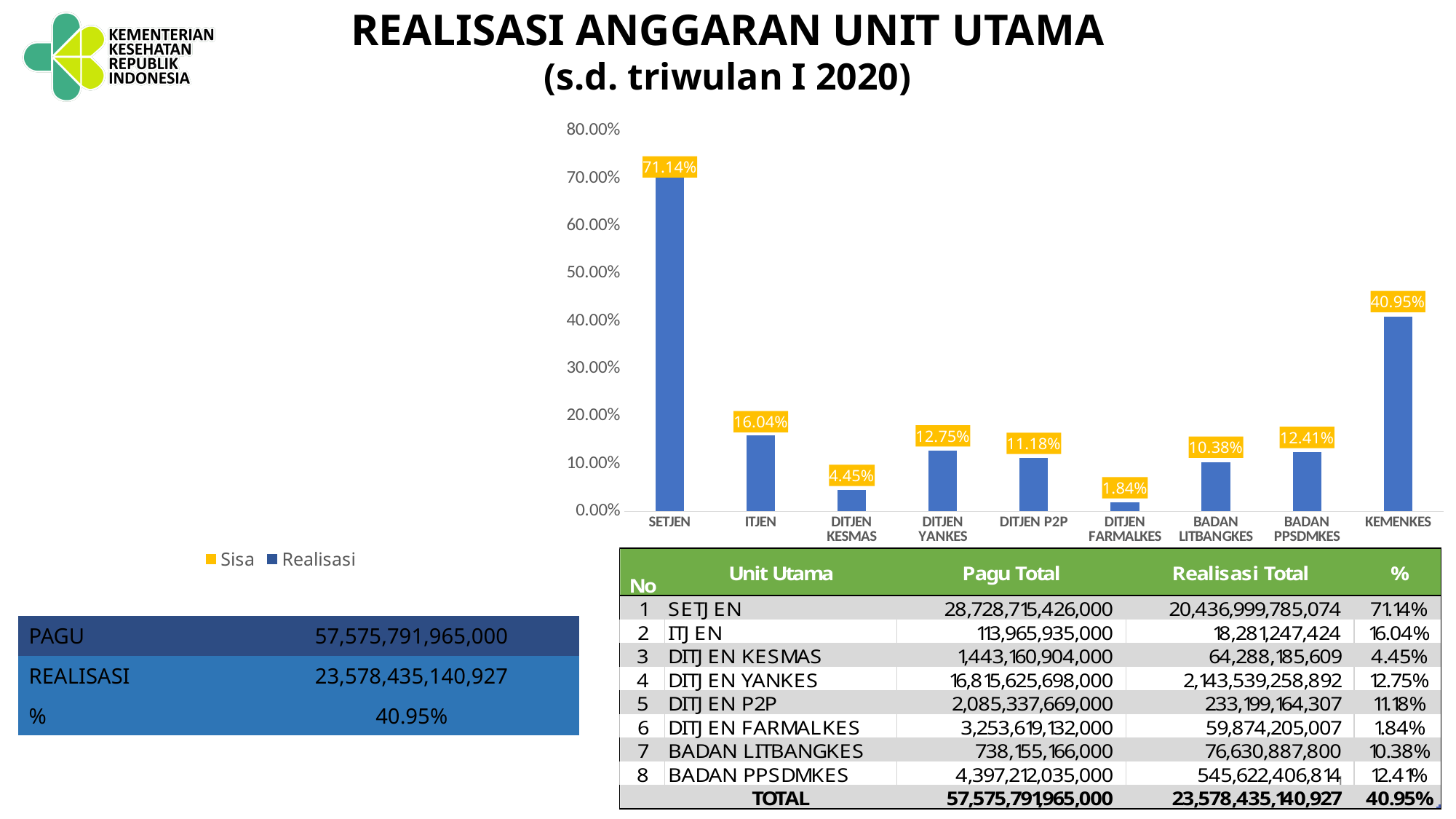
What is the value for SETJEN in the bar chart? 71.14% What is the highest value shown on the vertical axis of the bar chart? 80.00% What is the difference between the values for SETJEN and KEMENKES in the bar chart? 30.19% What kind of chart is shown on the slide? bar chart Is the value for KEMENKES in the bar chart greater or less than 30.00%? greater How many categories are shown on the x axis of the bar chart? 9 What is the value for BADAN LITBANGKES in the bar chart? 10.38% Which category has the highest value in the bar chart? SETJEN What is the difference between the values for ITJEN and DITJEN KESMAS in the bar chart? 11.59% Which is larger in the bar chart, the value for DITJEN YANKES or the value for DITJEN P2P? DITJEN YANKES Which category has the lowest value in the bar chart? DITJEN FARMALKES What is the value for DITJEN FARMALKES in the bar chart? 1.84%